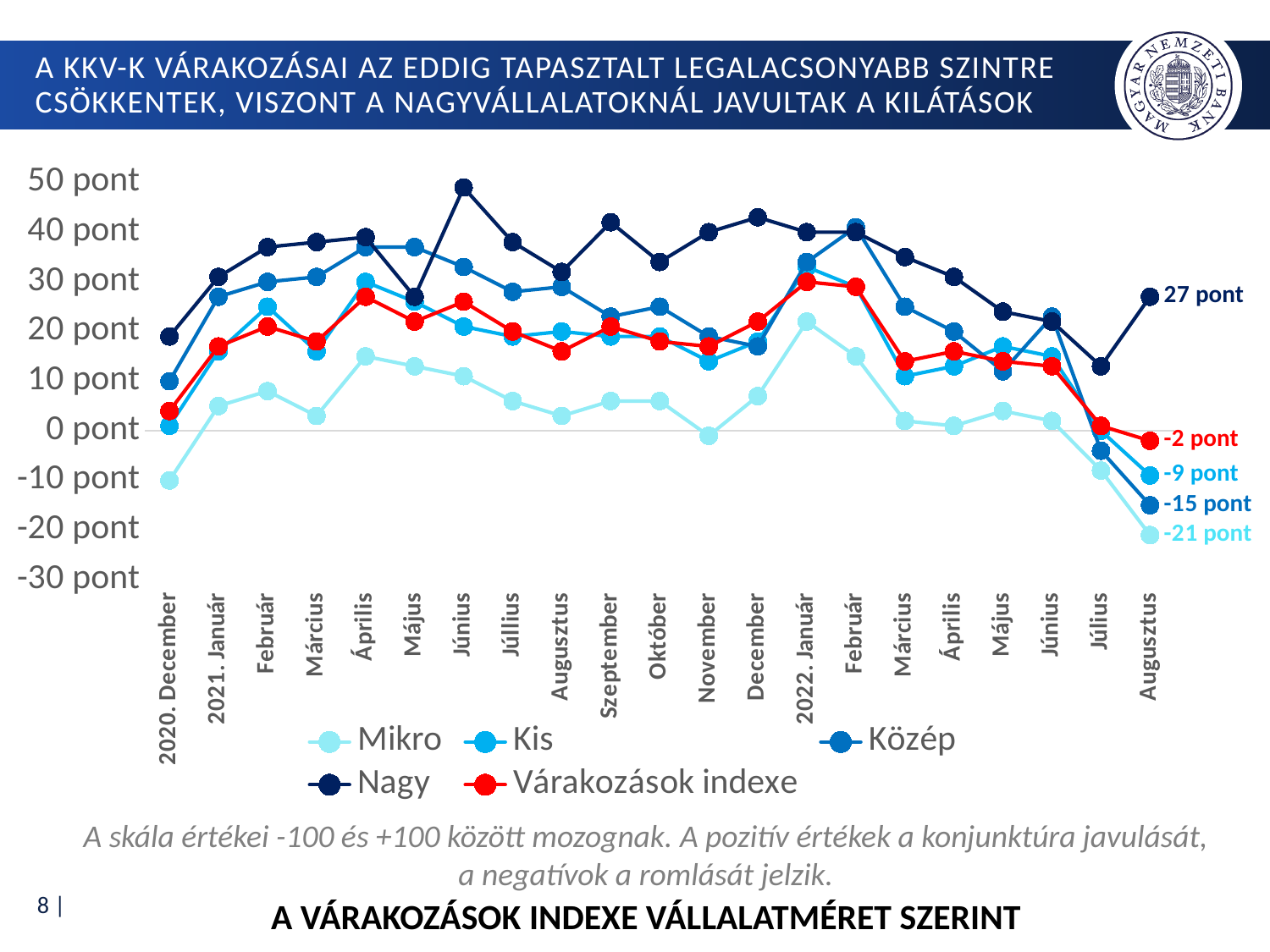
What is the value of the Várakozások indexe series in Augusztus (the last point)? -2 pont What is the value of the Kis series in Augusztus (the last point)? -9 pont What is the difference between the Nagy and Mikro values in Augusztus (the last point)? 48 pont Which series has the highest value in Augusztus (the last point)? Nagy What is the value of the Nagy series in Augusztus (the last point)? 27 pont What is the value of the Közép series in Augusztus (the last point)? -15 pont How many series does the legend list? 5 Which series has the lowest value in Augusztus (the last point)? Mikro What is the value of the Mikro series in Augusztus (the last point)? -21 pont What kind of chart is shown on the slide? line chart In Augusztus (the last point), which is larger: the Kis value or the Közép value? Kis Is the value of the Nagy series in 2021 Június greater or less than 40 pont? greater